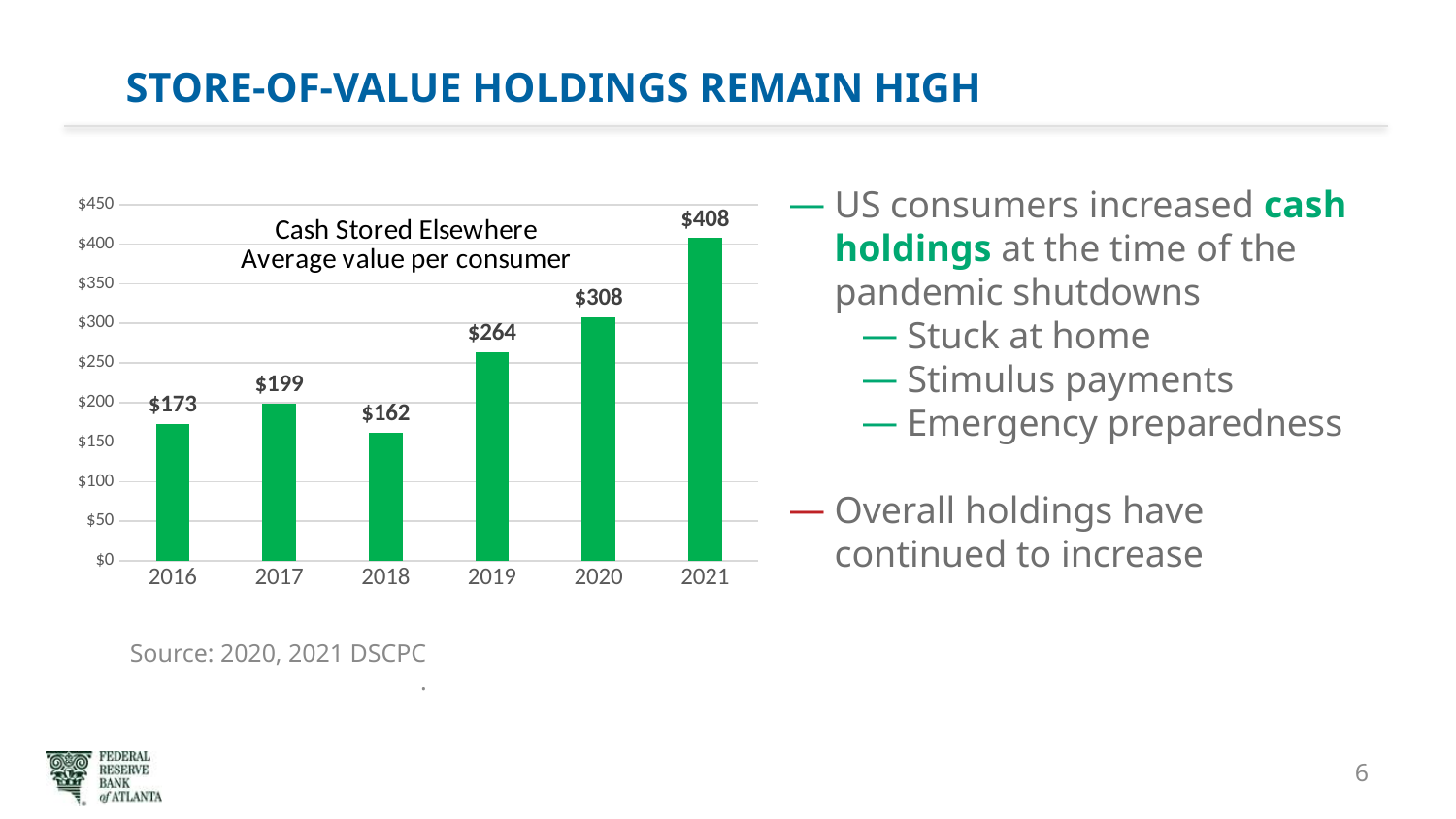
What is the average value of cash stored elsewhere per consumer in 2021? $408 What is the title of the chart? Cash Stored Elsewhere Average value per consumer Is the value for 2020 greater or less than $300? greater What kind of chart is shown on the slide? Bar chart What is the value shown for 2019? $264 How many years are shown on the chart? 6 Which is larger, the value for 2016 or the value for 2018? 2016 Which year has the lowest average value of cash stored elsewhere? 2018 What is the difference between the 2017 value and the 2016 value? $26 What is the average value of cash stored elsewhere per consumer in 2018? $162 Which year has the highest average value of cash stored elsewhere? 2021 What is the difference between the 2021 value and the 2020 value? $100